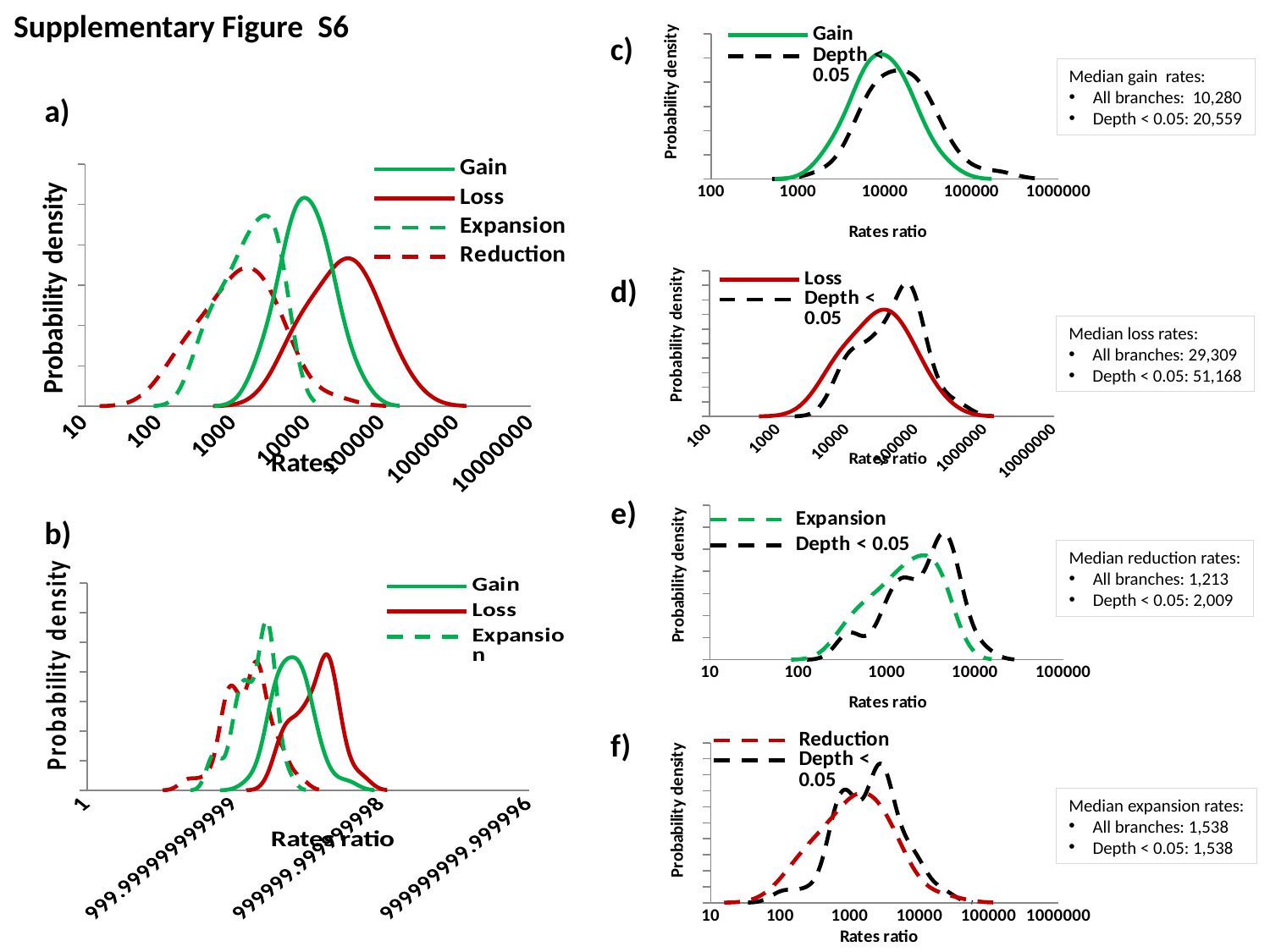
In chart c), how many series does the legend list? 2 In chart e), which curve peaks at a higher rates ratio, Expansion or Depth < 0.05? Depth < 0.05 In chart b), how many series does the legend list? 3 In chart a), which series has its peak at the highest rate value on the x axis? Loss What is the x-axis label of chart c)? Rates ratio In chart a), is the rate at which the Gain curve peaks greater or less than 1000? greater What kind of chart is chart a)? Line chart In chart a), how many series does the legend list? 4 In chart d), which curve has the higher peak, Loss or Depth < 0.05? Depth < 0.05 In chart c), how many tick labels are shown on the x axis? 5 In chart a), which series reaches the highest probability density peak? Gain In chart f), which series is drawn as a red dashed line? Reduction